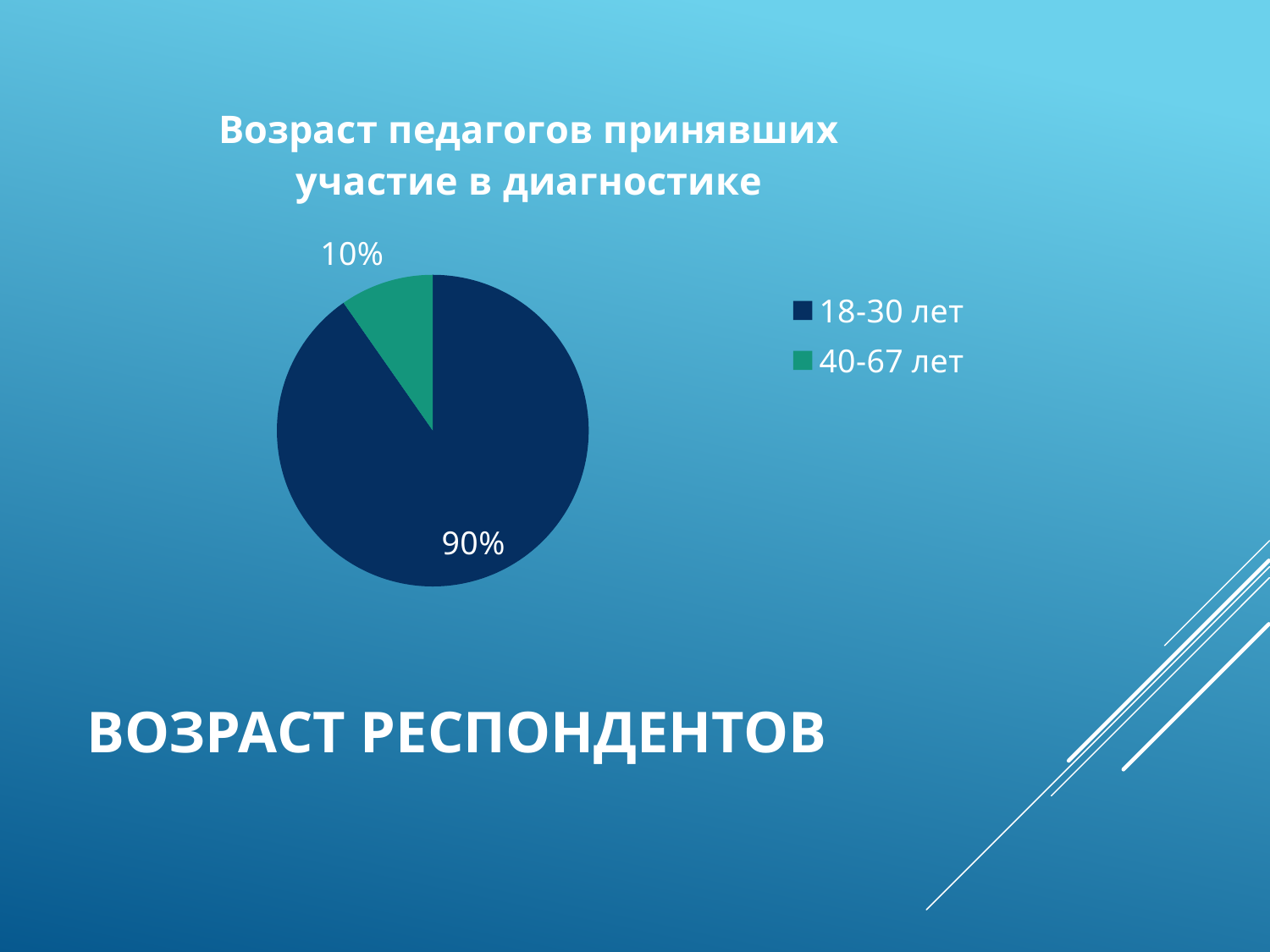
What share of the pie does the 40-67 лет slice represent? 10% How many slices does the pie chart have? 2 What share of the pie does the 18-30 лет slice represent? 90% Which age group has the smallest share of the pie? 40-67 лет What type of chart is shown on the slide? pie chart How many entries does the legend list? 2 Which age group has the largest share of the pie? 18-30 лет What colour is the 40-67 лет slice? green Which slice is larger: 18-30 лет or 40-67 лет? 18-30 лет What is the difference in percentage points between the 18-30 лет and 40-67 лет slices? 80 percentage points What is the title of the chart? Возраст педагогов принявших участие в диагностике